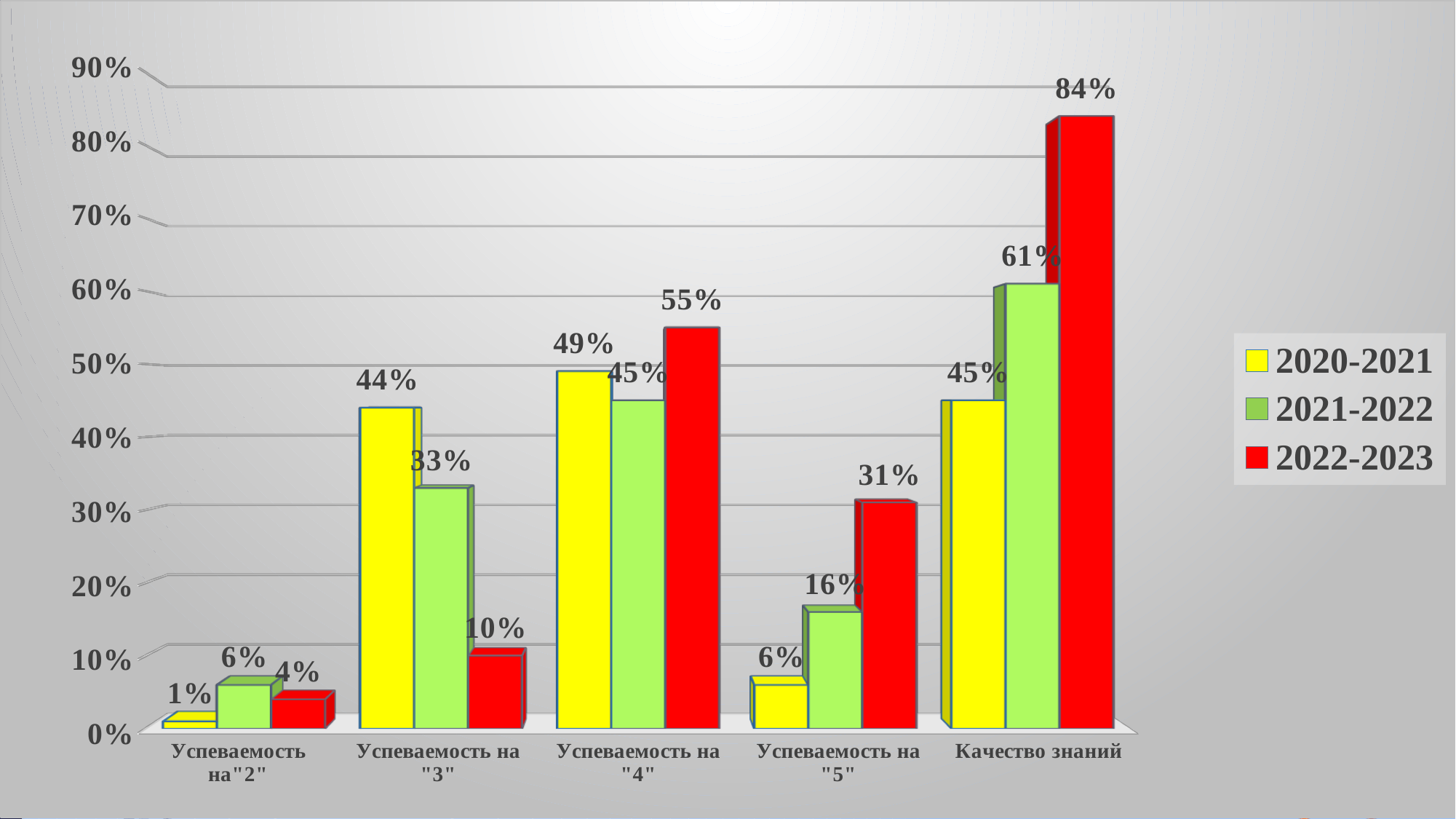
What is the value for 2020-2021 in the Успеваемость на "3" category? 44% Which category has the highest value for the 2022-2023 series? Качество знаний How many series does the legend list? 3 Which colour represents the 2021-2022 series in the legend? Green Which category has the lowest value for the 2020-2021 series? Успеваемость на "2" What is the difference between the 2022-2023 and 2020-2021 values in the Качество знаний category? 39% What is the value for 2021-2022 in the Успеваемость на "5" category? 16% Is the value for 2022-2023 in the Успеваемость на "4" category greater or less than 50%? greater What kind of chart is shown on the slide? Bar chart How many categories are shown on the x axis? 5 In the Успеваемость на "3" category, which series has the larger value: 2020-2021 or 2022-2023? 2020-2021 What is the value for 2022-2023 in the Качество знаний category? 84%